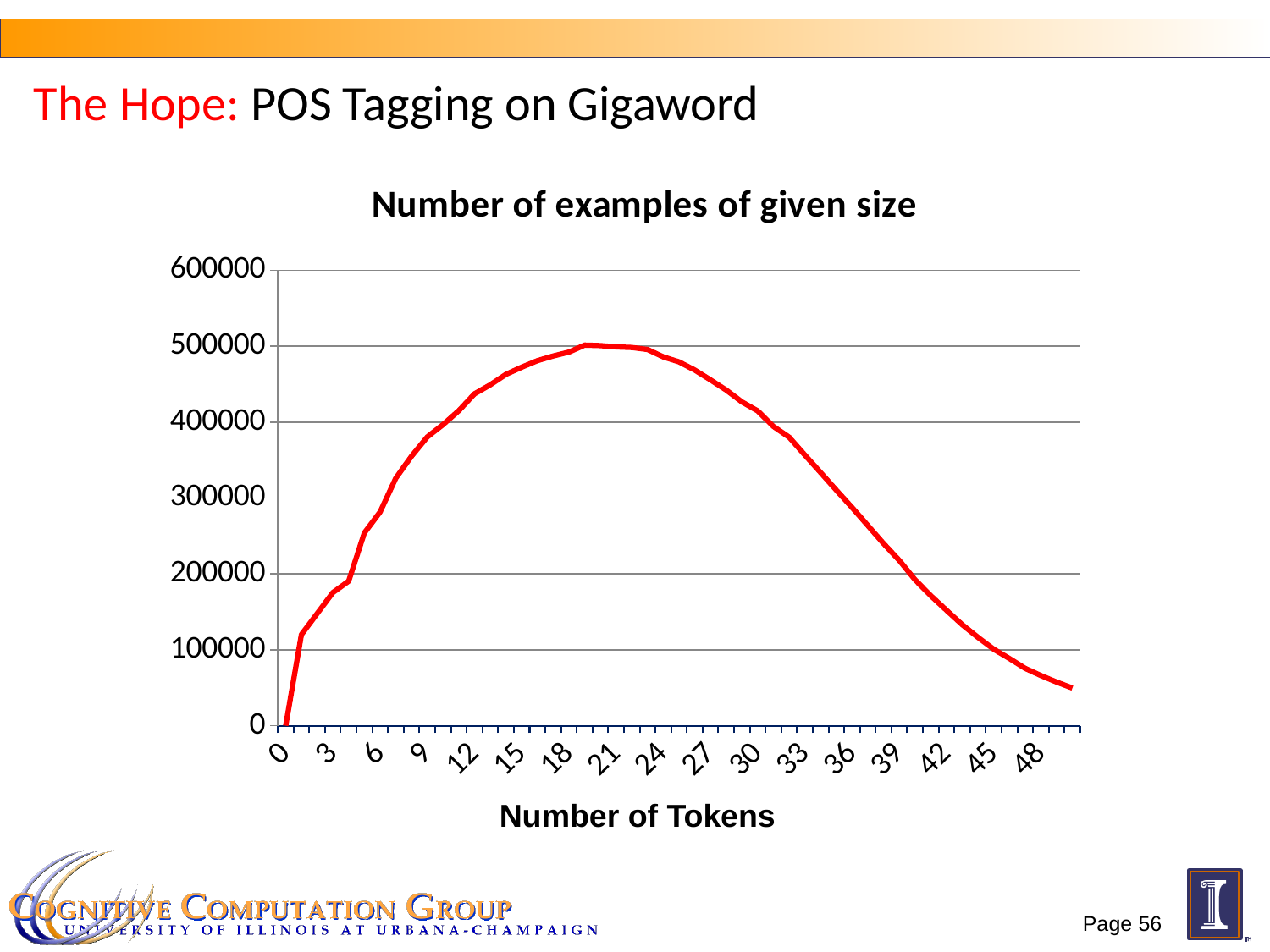
Is the value at 3 tokens greater or less than 100000? greater What kind of chart is shown on the slide? line chart Is the peak value of the line greater or less than 600000? less Does the line rise or fall between 24 and 48 tokens? fall Is the value at 6 tokens greater or less than 300000? less Which is larger, the value at 12 tokens or the value at 42 tokens? 12 tokens What is the title of the chart? Number of examples of given size What is the label of the x axis? Number of Tokens How many labelled tick marks are on the x axis? 17